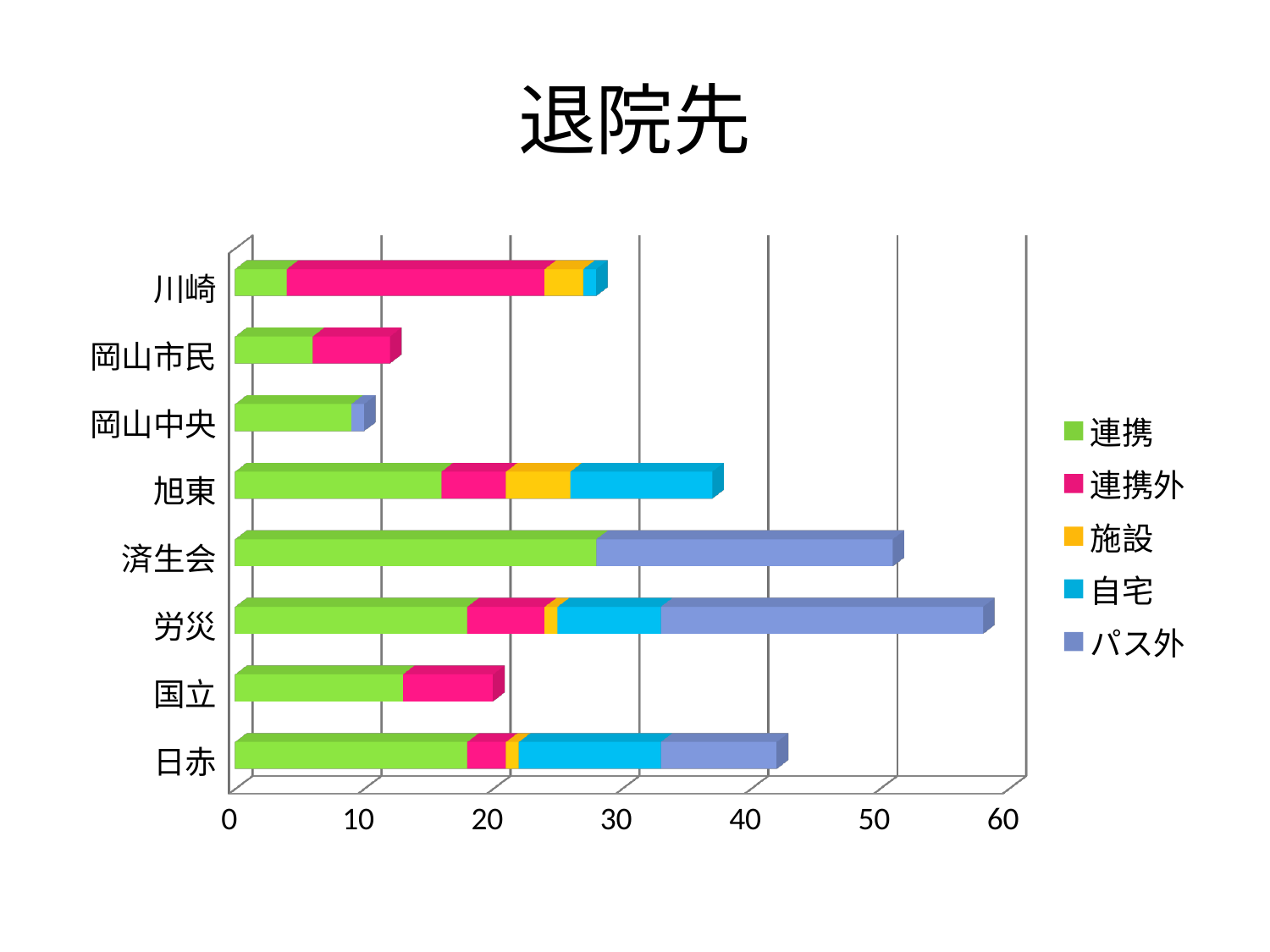
What is the title of the chart? 退院先 Which has the longer total bar, 済生会 or 旭東? 済生会 How many series does the legend list? 5 How many categories (hospitals) are shown on the vertical axis? 8 Is the total bar length for 国立 greater or less than 30? less Which category has the longest total bar? 労災 Is the total bar length for 旭東 greater or less than 40? less Is the total bar length for 済生会 greater or less than 40? greater What type of chart is shown on the slide? bar chart Which category has the shortest total bar? 岡山中央 Which legend entry is shown in green? 連携